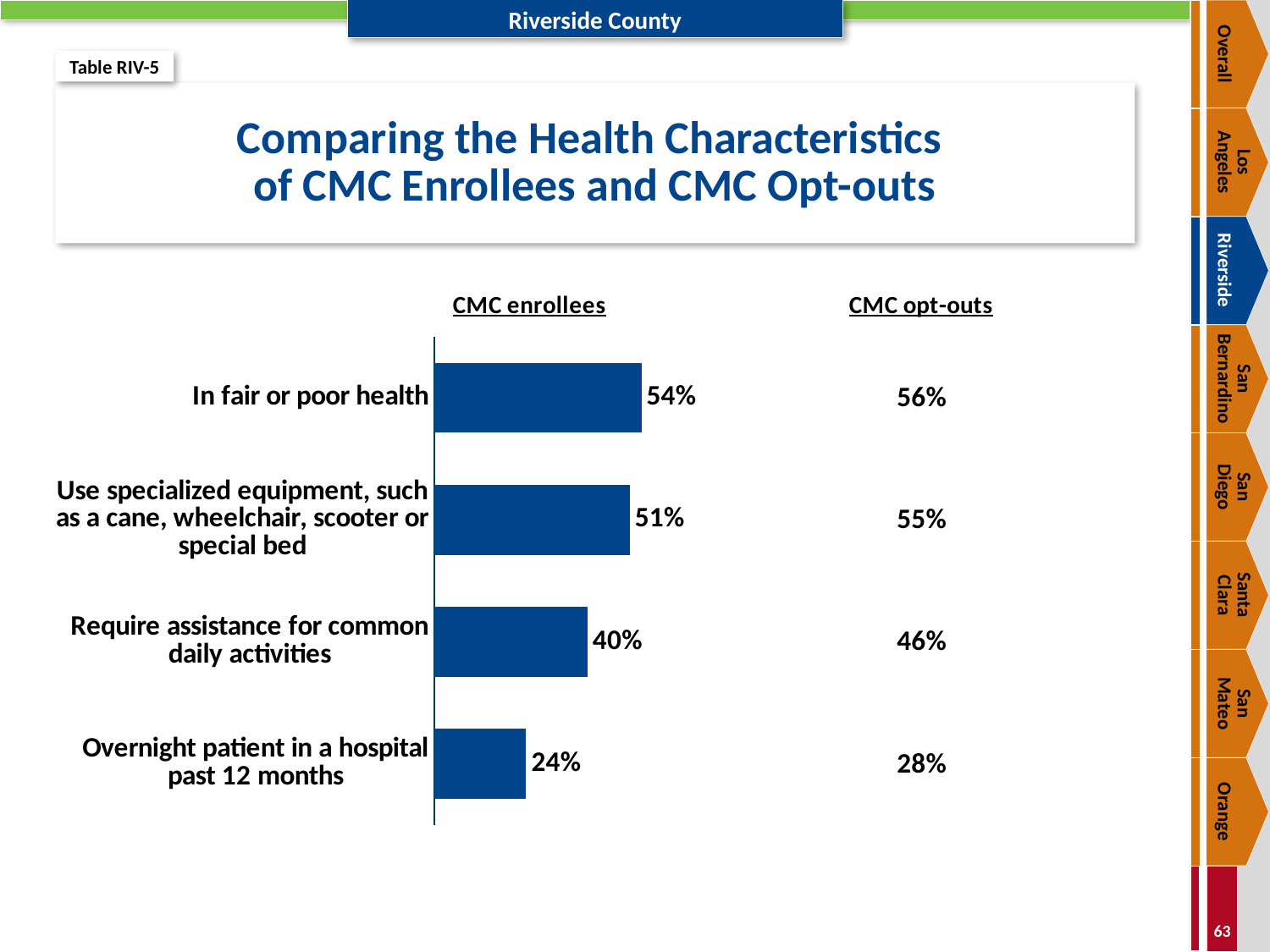
Which category has the lowest CMC enrollees value? Overnight patient in a hospital past 12 months What is the CMC enrollees value for 'In fair or poor health'? 54% For 'Overnight patient in a hospital past 12 months', which is larger: the CMC enrollees value or the CMC opt-outs value? CMC opt-outs What is the difference between the CMC enrollees values for 'In fair or poor health' and 'Overnight patient in a hospital past 12 months'? 30% Which category has the highest CMC enrollees value? In fair or poor health What is the difference between the CMC opt-outs and CMC enrollees values for 'Require assistance for common daily activities'? 6% What is the CMC opt-outs value for 'Use specialized equipment, such as a cane, wheelchair, scooter or special bed'? 55% How many health characteristic categories are shown in the chart? 4 What is the CMC enrollees value for 'Overnight patient in a hospital past 12 months'? 24% What kind of chart is used to show the CMC enrollees values? Bar chart What is the CMC opt-outs value for 'Require assistance for common daily activities'? 46% What is the title of the chart? Comparing the Health Characteristics of CMC Enrollees and CMC Opt-outs